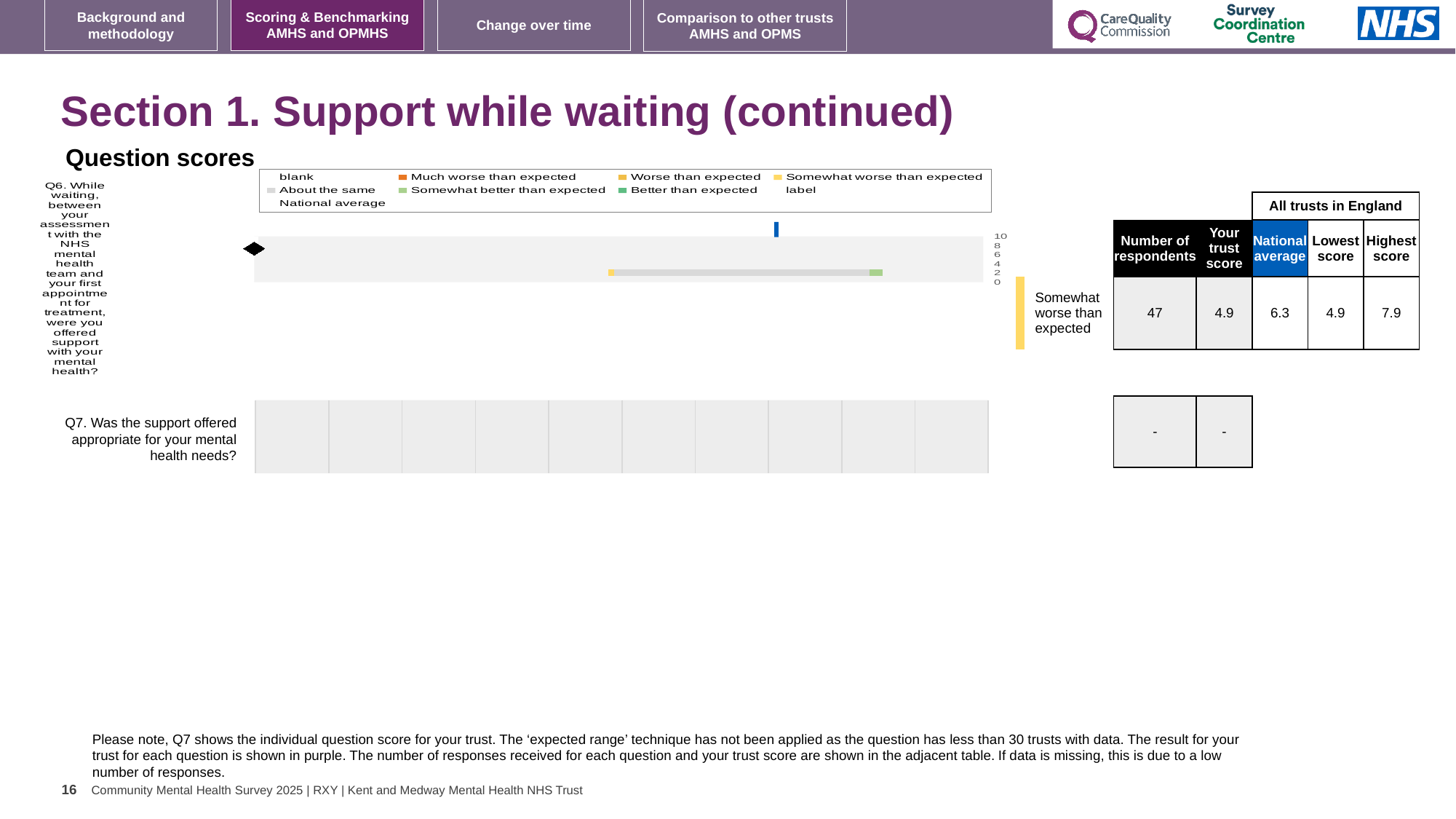
What is the national average score for Q6? 6.3 What is the difference between the highest score and the lowest score for Q6? 3.0 What is the lowest score among all trusts in England for Q6? 4.9 Is the trust score for Q6 higher or lower than the national average? lower What is the trust score for Q6 (support while waiting between assessment and first appointment)? 4.9 Is the trust score for Q6 greater or less than 6? less What is the difference between the national average and the trust score for Q6? 1.4 What is the highest score among all trusts in England for Q6? 7.9 How many respondents answered Q6? 47 What kind of chart is used for the Question scores? bar chart How many questions are plotted in the Question scores chart? 2 Which expected-range category is the trust's Q6 score placed in? Somewhat worse than expected